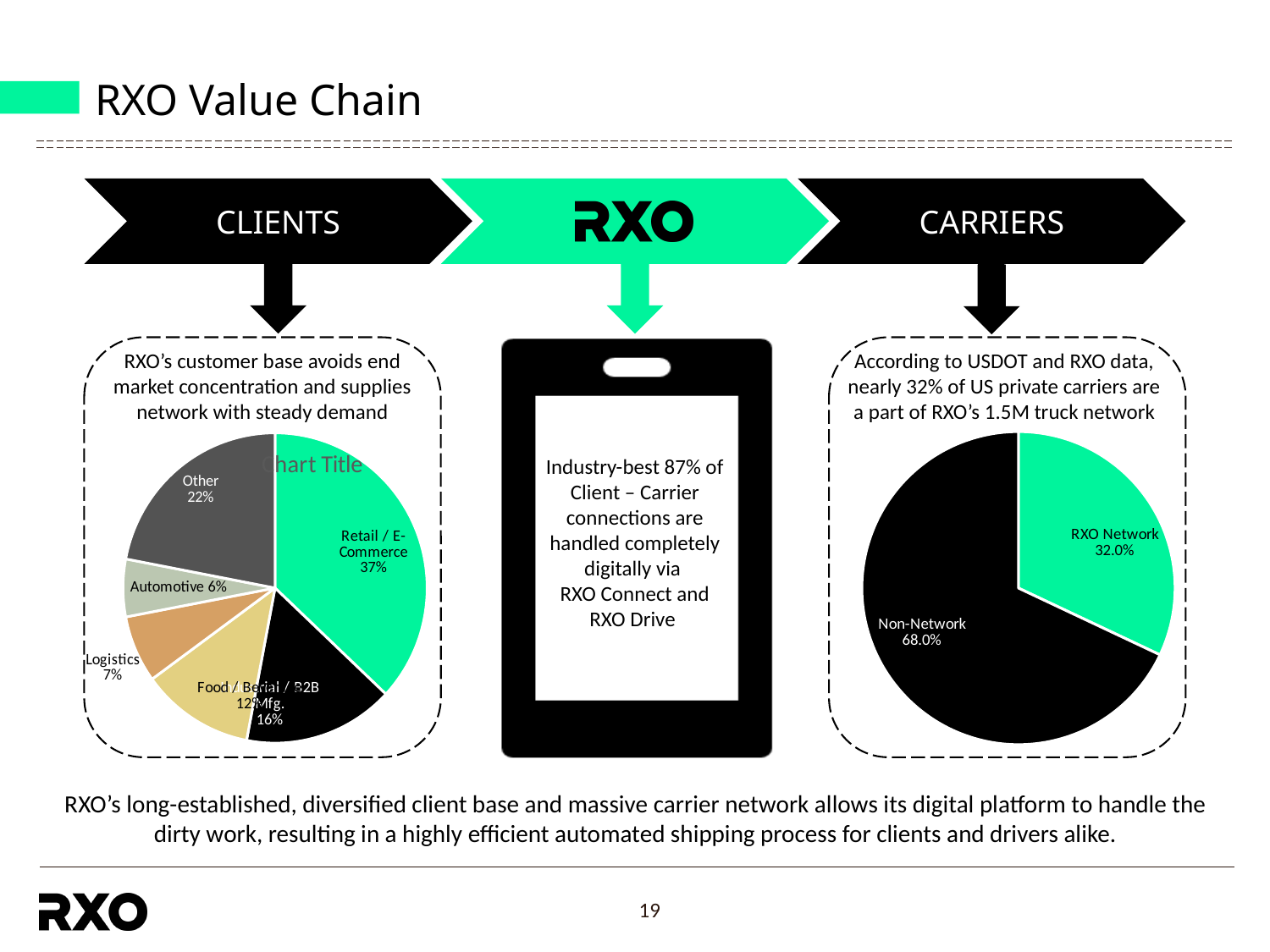
On the left-hand pie chart (clients), how many percentage points larger is Retail / E-Commerce than Other? 15% How many slices does the right-hand pie chart (carriers) have? 2 What kind of chart is used under the CARRIERS heading? Pie chart On the left-hand pie chart (clients), what percentage is labelled for Other? 22% On the right-hand pie chart (carriers), what share is labelled for Non-Network? 68.0% On the right-hand pie chart (carriers), what share is labelled for RXO Network? 32.0% On the left-hand pie chart (clients), which category has the smallest share? Automotive On the left-hand pie chart (clients), what percentage is labelled for Retail / E-Commerce? 37% On the right-hand pie chart (carriers), what is the difference in percentage points between Non-Network and RXO Network? 36.0% On the left-hand pie chart (clients), which category has the largest share? Retail / E-Commerce On the left-hand pie chart (clients), what percentage is labelled for Automotive? 6% On the right-hand pie chart (carriers), which slice is larger, RXO Network or Non-Network? Non-Network